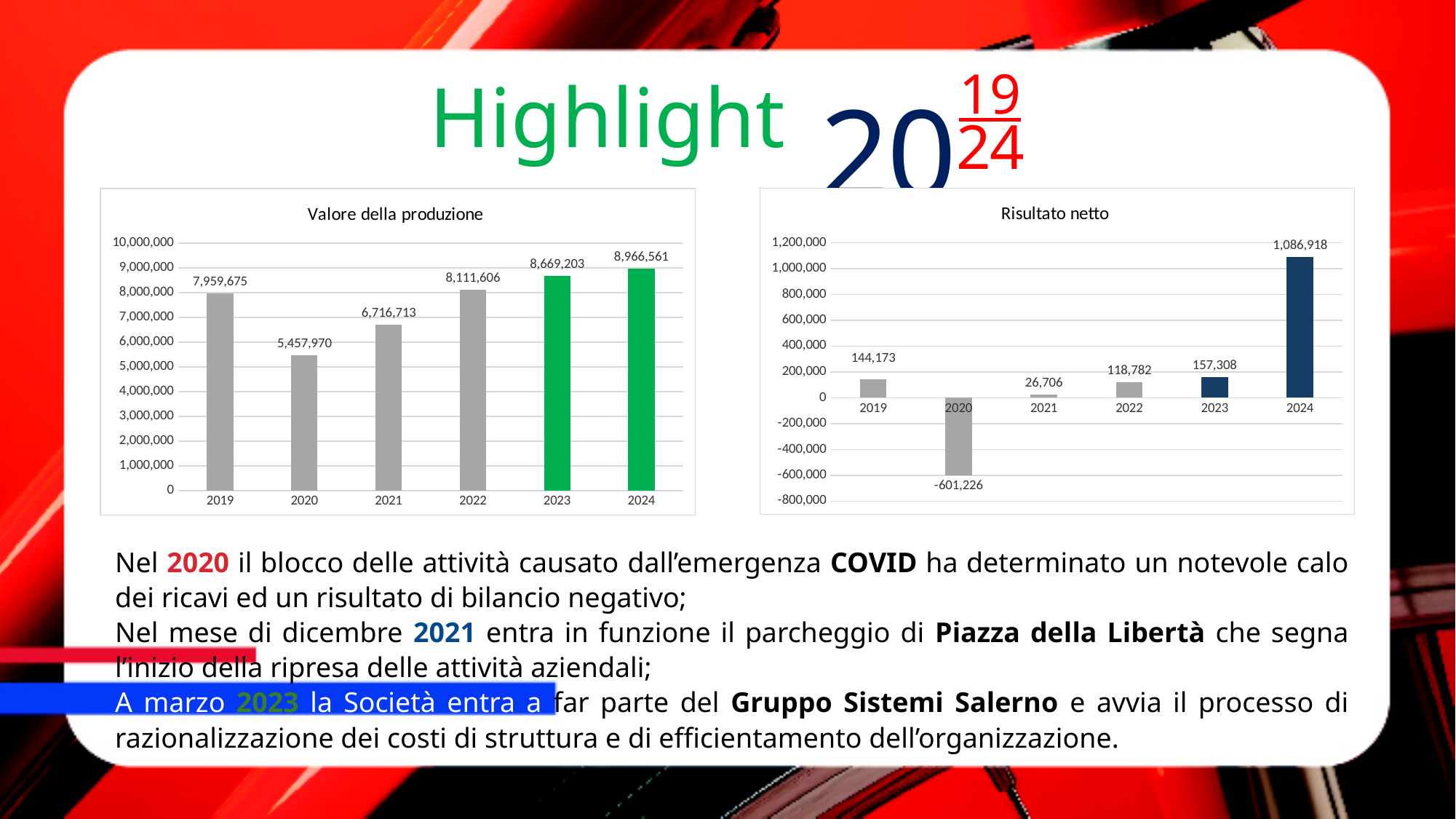
In the 'Risultato netto' chart, what is the difference between the 2024 and 2023 values? 929,610 In the 'Valore della produzione' chart, what is the difference between the 2024 and 2023 values? 297,358 In the 'Risultato netto' chart, which is larger, the value for 2019 or the value for 2022? 2019 What kind of chart is the 'Risultato netto' chart? Bar chart In the 'Risultato netto' chart, what is the value for 2020? -601,226 In the 'Risultato netto' chart, what is the value for 2024? 1,086,918 In the 'Risultato netto' chart, which year has the lowest value? 2020 In the 'Valore della produzione' chart, how many years are shown? 6 In the 'Valore della produzione' chart, what is the value for 2020? 5,457,970 In the 'Valore della produzione' chart, do the values rise or fall from 2020 to 2024? Rise In the 'Valore della produzione' chart, which year has the highest value? 2024 In the 'Valore della produzione' chart, which year has the lowest value? 2020